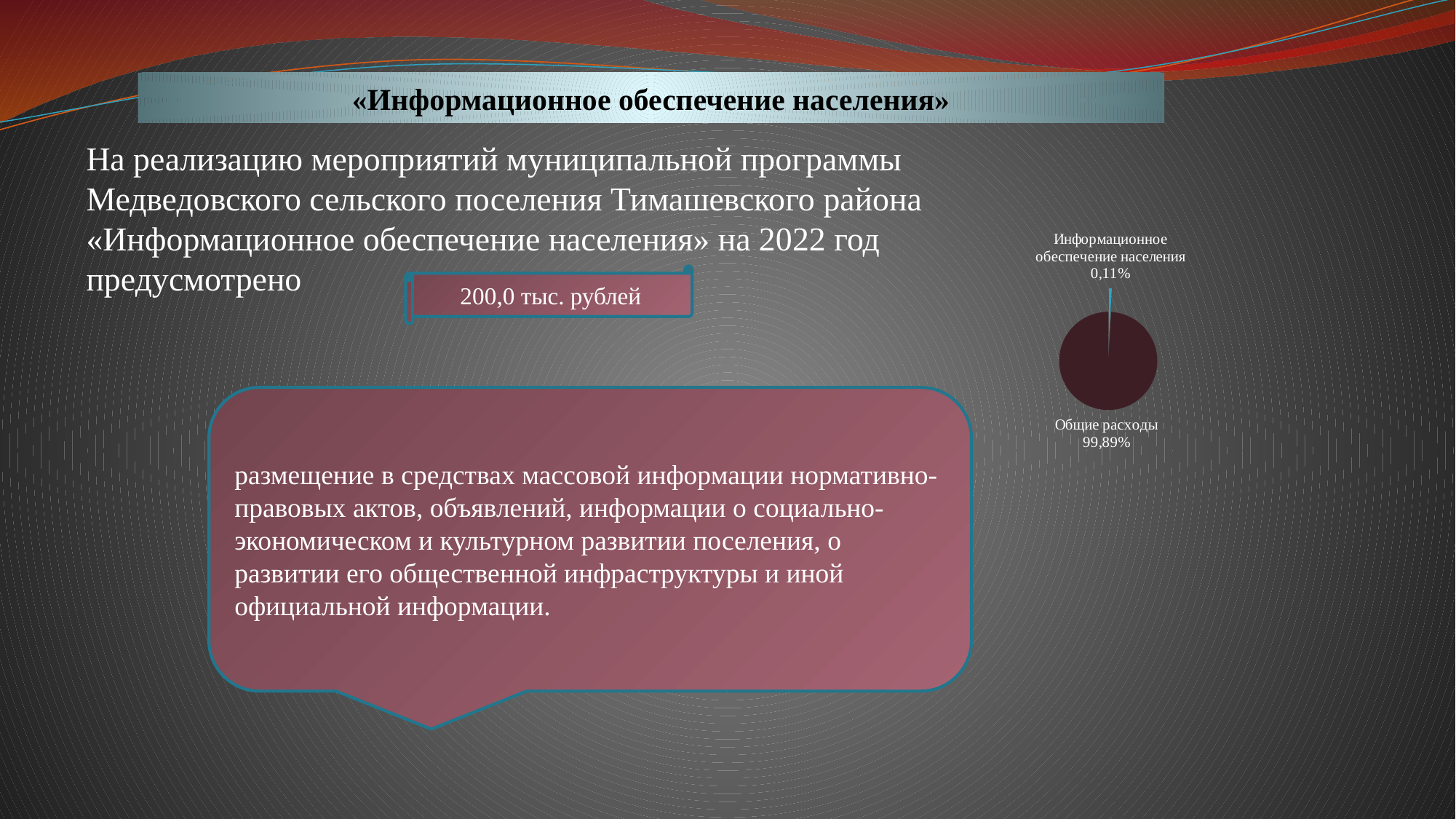
Is the share for «Общие расходы» greater or less than 50%? greater Which is larger in the pie chart: «Общие расходы» or «Информационное обеспечение населения»? Общие расходы Which slice of the pie chart is the smallest? Информационное обеспечение населения What share of the pie chart is labelled «Информационное обеспечение населения»? 0,11% Which slice of the pie chart is the largest? Общие расходы Is the share for «Информационное обеспечение населения» greater or less than 1%? less What is the difference in percentage points between the «Общие расходы» slice and the «Информационное обеспечение населения» slice? 99,78 How many slices does the pie chart have? 2 What share of the pie chart is labelled «Общие расходы»? 99,89% What are the two category labels shown on the pie chart? Информационное обеспечение населения; Общие расходы What kind of chart is shown on the right side of the slide? pie chart